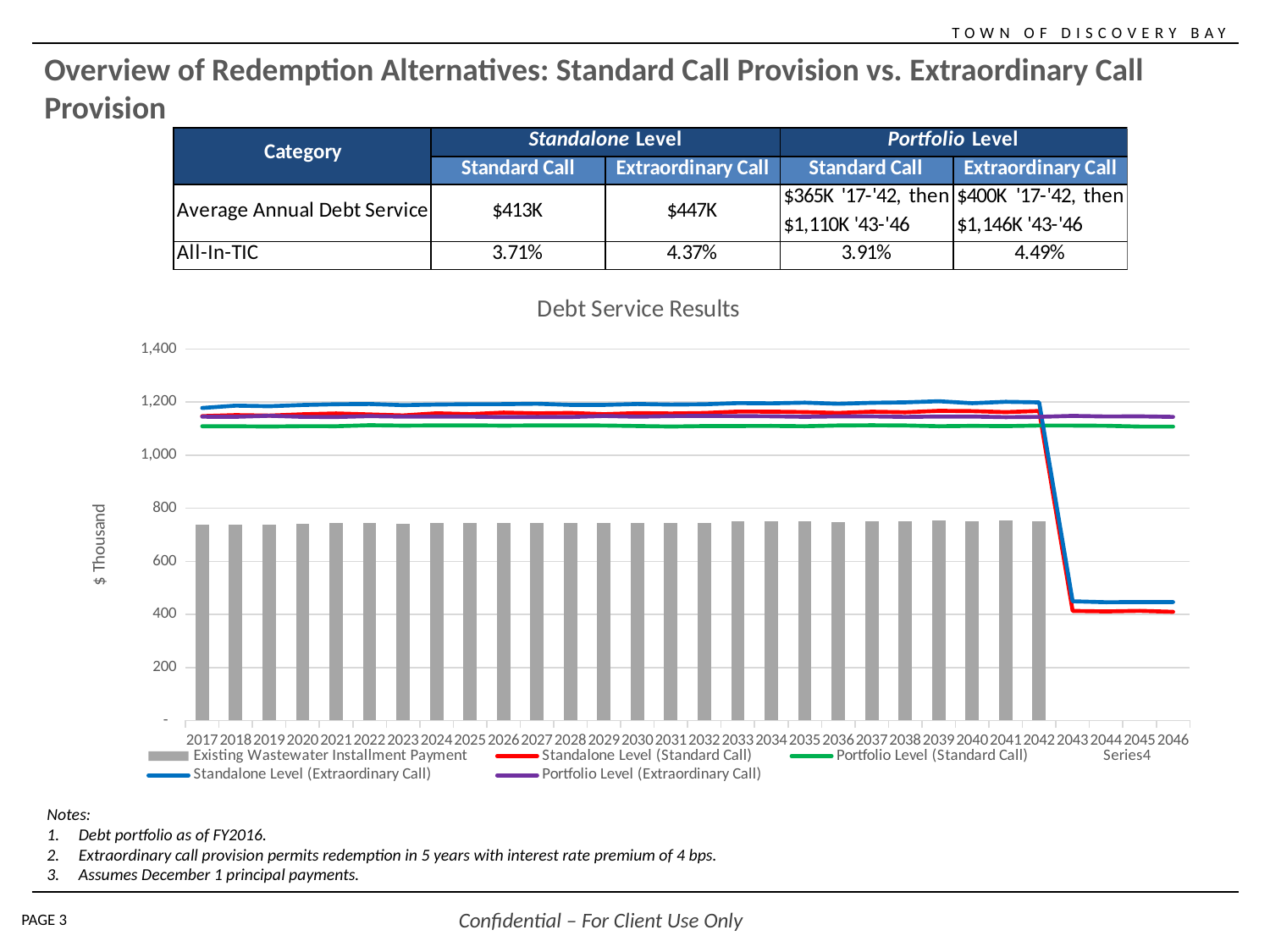
How many years have an Existing Wastewater Installment Payment bar in the Debt Service Results chart? 26 In the Debt Service Results chart, is the Portfolio Level (Standard Call) value for 2030 greater or less than 1,000? greater In the Debt Service Results chart, which is higher in 2030: Portfolio Level (Extraordinary Call) or Portfolio Level (Standard Call)? Portfolio Level (Extraordinary Call) In the Debt Service Results chart, which is higher in 2044: Standalone Level (Extraordinary Call) or Standalone Level (Standard Call)? Standalone Level (Extraordinary Call) What kind of chart is the Debt Service Results chart? bar and line chart In the Debt Service Results chart, is the Existing Wastewater Installment Payment bar for 2030 greater or less than 600? greater How many series does the legend of the Debt Service Results chart list? 6 What is the y-axis label of the Debt Service Results chart? $ Thousand In the Debt Service Results chart, is the Existing Wastewater Installment Payment bar for 2017 greater or less than 800? less In the Debt Service Results chart, does the Standalone Level (Standard Call) line rise or fall between 2042 and 2043? fall How many years are shown on the x axis of the Debt Service Results chart? 30